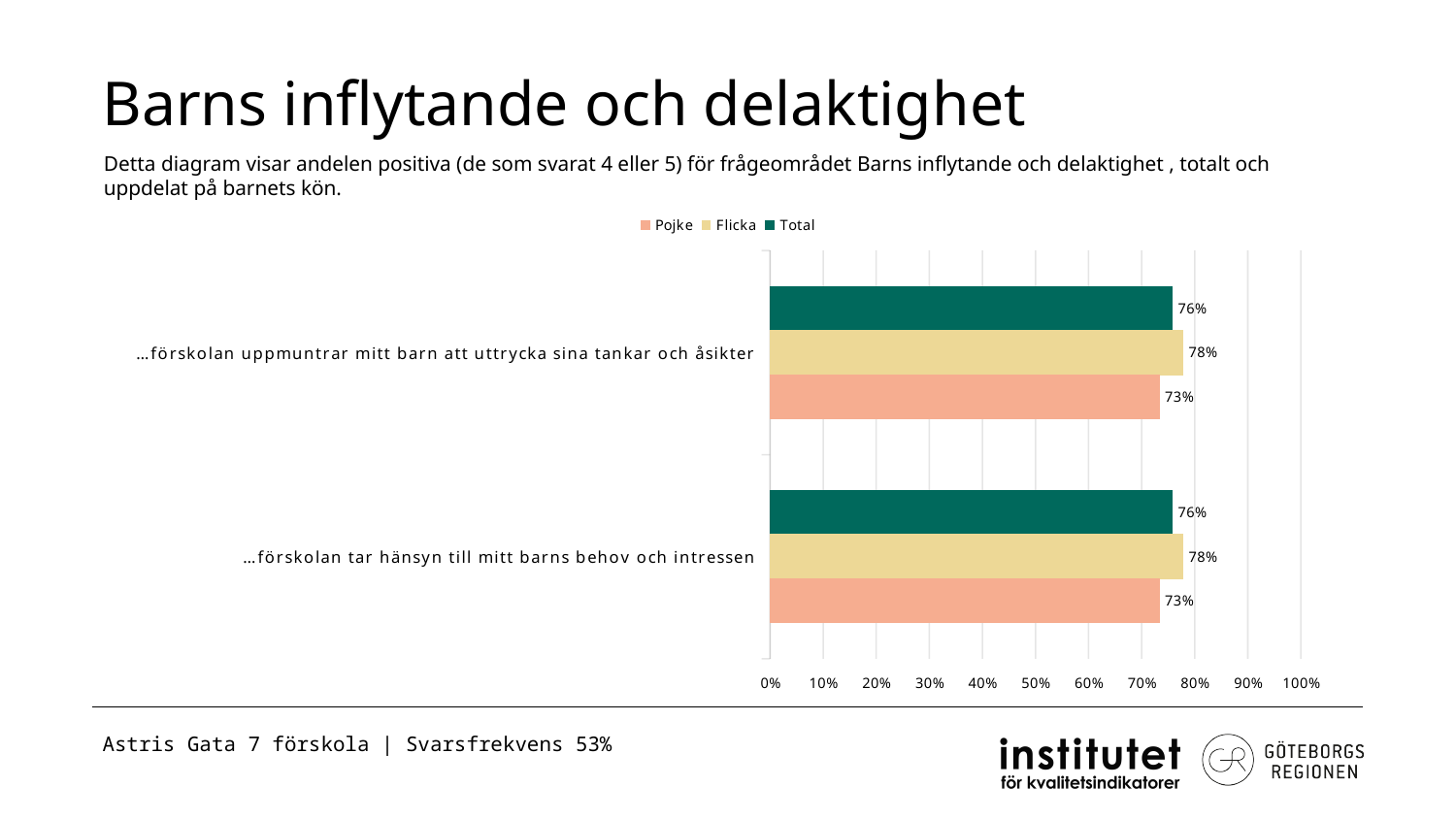
What is the difference between the Flicka and Pojke values for "…förskolan tar hänsyn till mitt barns behov och intressen"? 5% Which series has the lowest value for "…förskolan uppmuntrar mitt barn att uttrycka sina tankar och åsikter"? Pojke How many series does the legend list? 3 Is the Flicka value for "…förskolan uppmuntrar mitt barn att uttrycka sina tankar och åsikter" larger or smaller than the Total value for the same category? larger What is the Flicka value for "…förskolan tar hänsyn till mitt barns behov och intressen"? 78% What kind of chart is shown on the slide? bar chart Which series has the highest value for "…förskolan tar hänsyn till mitt barns behov och intressen"? Flicka Which legend entry is shown in dark green? Total How many categories are shown on the chart? 2 What is the Pojke value for "…förskolan uppmuntrar mitt barn att uttrycka sina tankar och åsikter"? 73% What is the Total value for "…förskolan uppmuntrar mitt barn att uttrycka sina tankar och åsikter"? 76% Is the Pojke value for "…förskolan tar hänsyn till mitt barns behov och intressen" greater or less than 80%? less